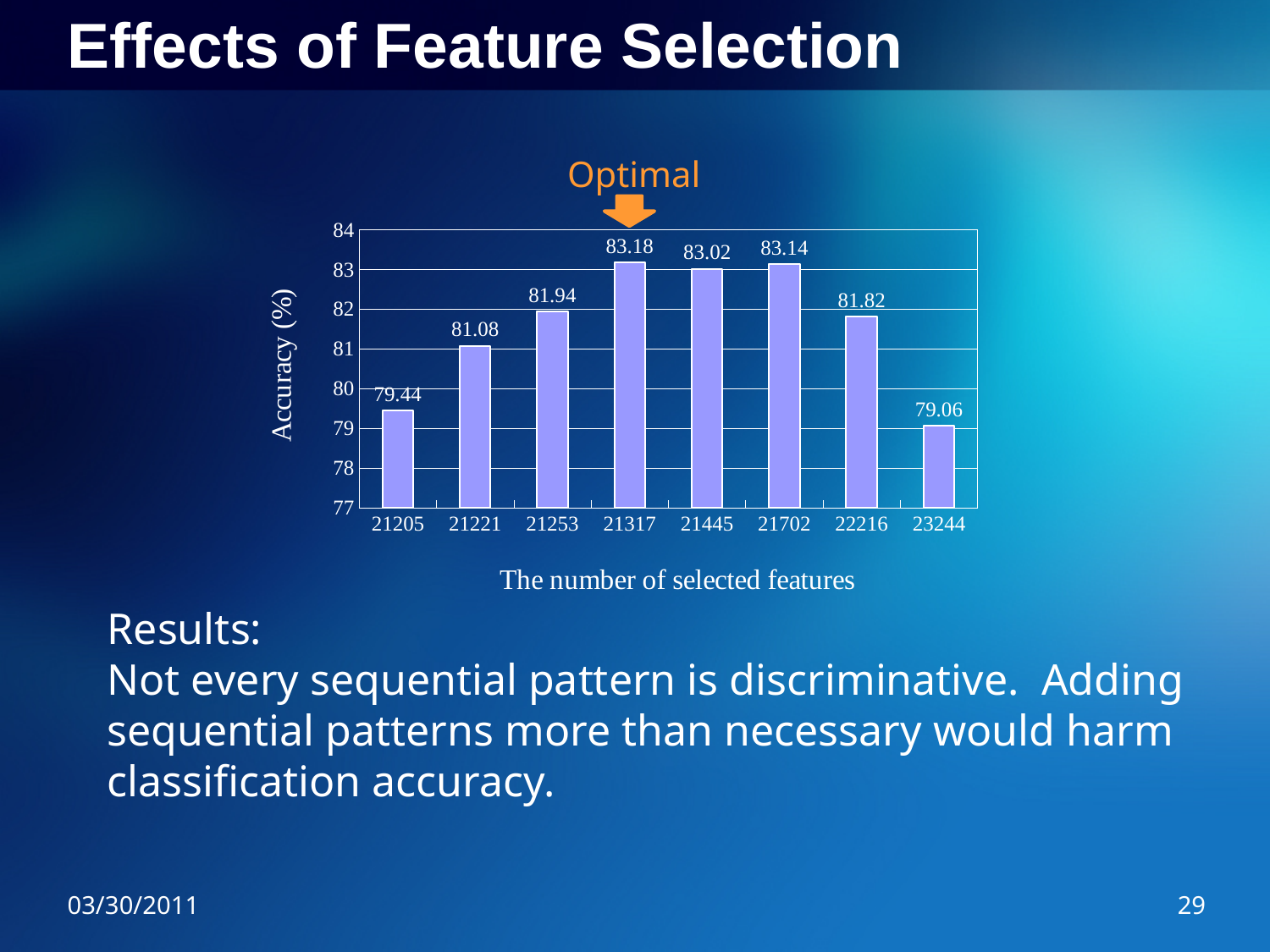
What is the accuracy (%) for 21317 selected features? 83.18 Which bar is marked as 'Optimal' by the arrow? 21317 What is the label of the y axis? Accuracy (%) What is the accuracy (%) for 23244 selected features? 79.06 What kind of chart is shown on the slide? bar chart How many bars are shown in the chart? 8 Which has higher accuracy: 21221 or 22216 selected features? 22216 What is the accuracy (%) for 21253 selected features? 81.94 Which number of selected features gives the highest accuracy? 21317 Which number of selected features gives the lowest accuracy? 23244 Is the accuracy for 21445 selected features greater or less than 82? greater What is the difference in accuracy between 21317 and 21205 selected features? 3.74